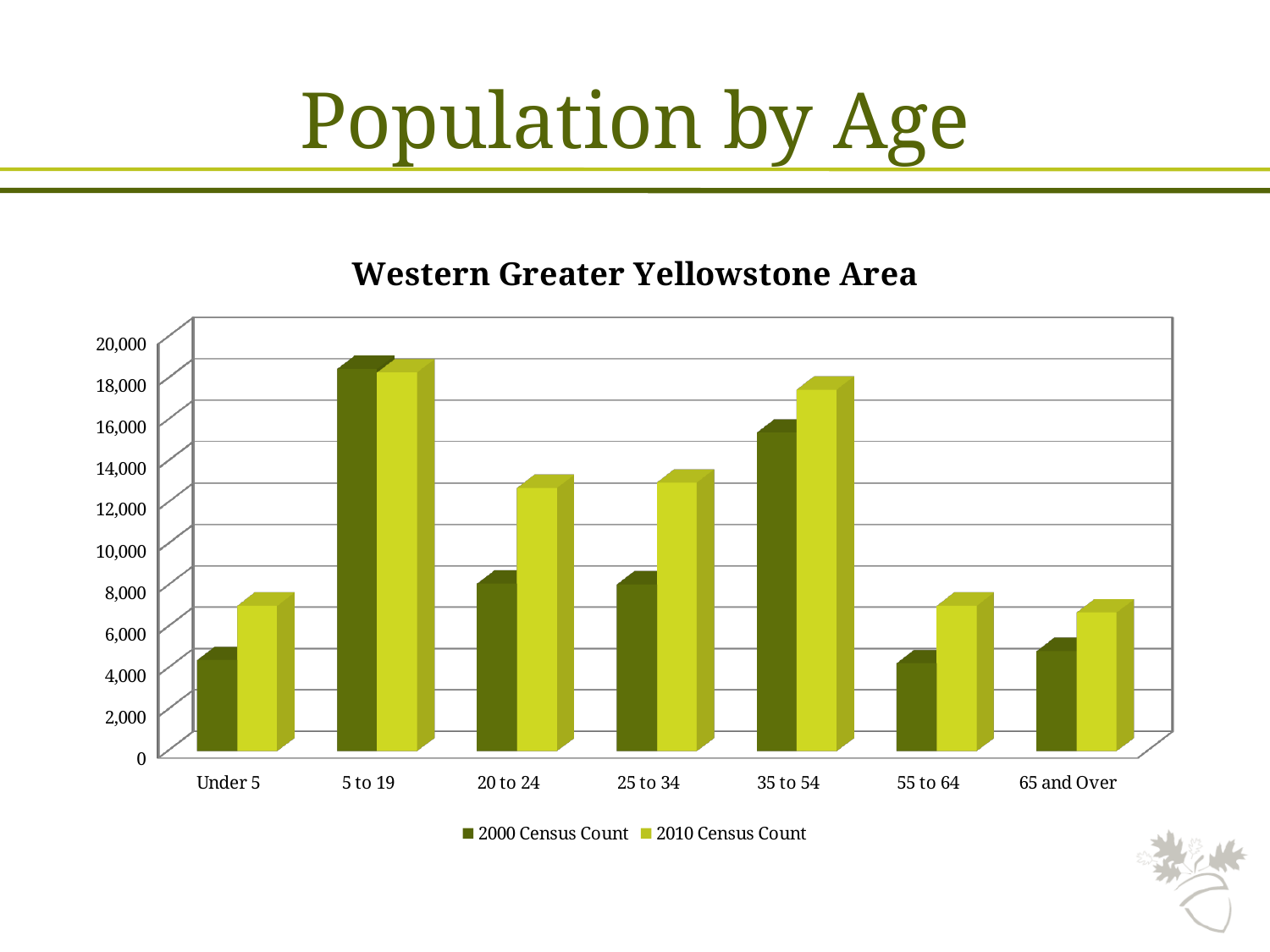
Is the 2010 Census Count for 25 to 34 greater or less than 12,000? greater What are the two series named in the legend? 2000 Census Count and 2010 Census Count For the 35 to 54 age group, which is larger: the 2000 Census Count or the 2010 Census Count? 2010 Census Count For the 20 to 24 age group, which is larger: the 2000 Census Count or the 2010 Census Count? 2010 Census Count What is the title of the chart? Western Greater Yellowstone Area Is the 2000 Census Count for Under 5 greater or less than 6,000? less Is the 2000 Census Count for 35 to 54 greater or less than 14,000? greater How many series does the legend list? 2 Which age category has the highest 2010 Census Count? 5 to 19 How many age categories are shown on the x axis? 7 What kind of chart is shown on the slide? bar chart Which age category has the highest 2000 Census Count? 5 to 19